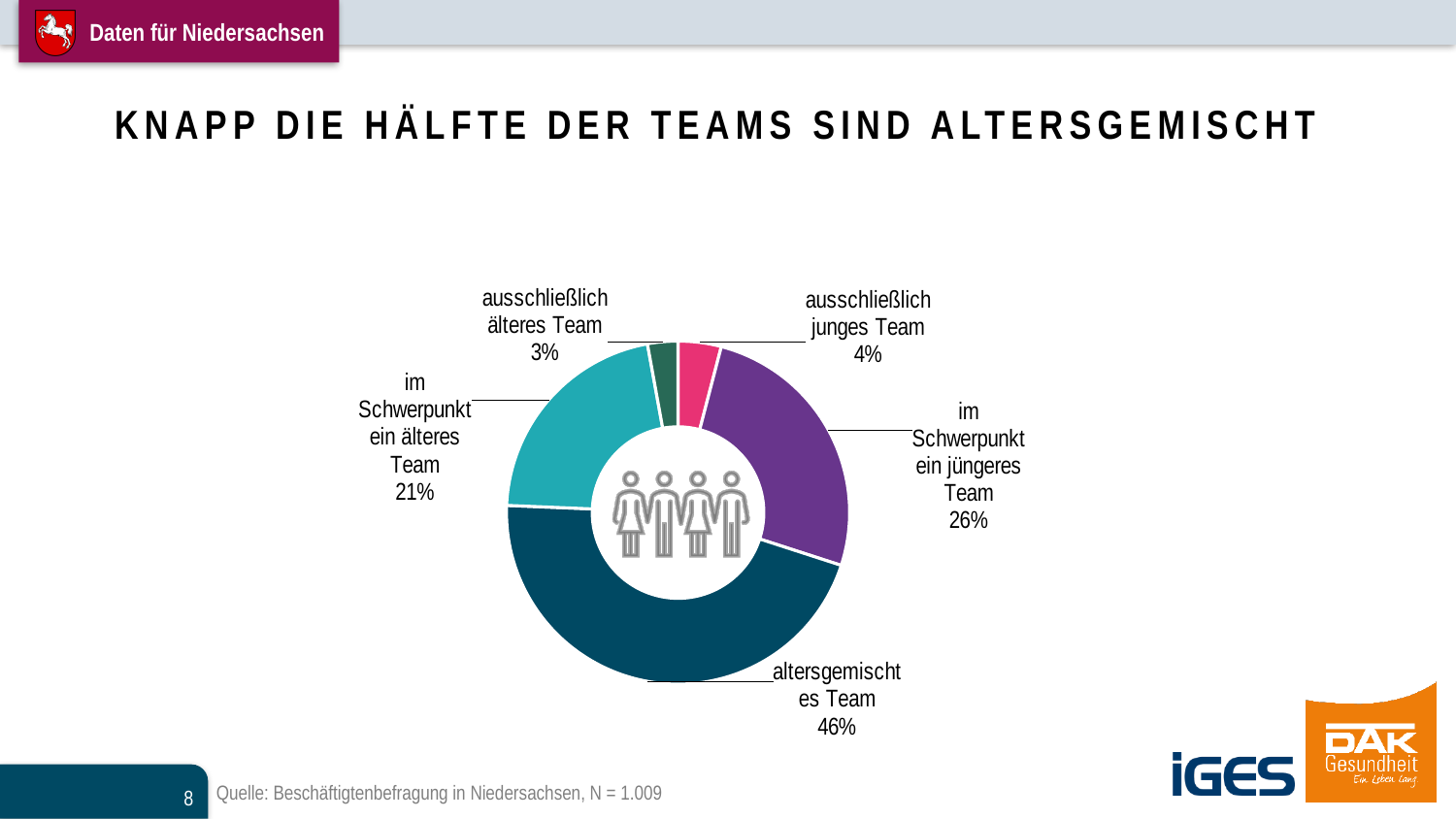
What share of teams is labelled "altersgemischtes Team"? 46% What is the title of the slide? KNAPP DIE HÄLFTE DER TEAMS SIND ALTERSGEMISCHT How many categories are shown in the chart? 5 Which category has the largest share of the chart? altersgemischtes Team Which is larger: the share for "ausschließlich junges Team" or for "ausschließlich älteres Team"? ausschließlich junges Team What is the difference in percentage points between "im Schwerpunkt ein jüngeres Team" and "im Schwerpunkt ein älteres Team"? 5 percentage points What kind of chart is shown on the slide? Pie chart (donut) What percentage is shown for "ausschließlich junges Team"? 4% What percentage is shown for "ausschließlich älteres Team"? 3% What percentage is shown for "im Schwerpunkt ein jüngeres Team"? 26% What percentage is shown for "im Schwerpunkt ein älteres Team"? 21% Which category has the smallest share of the chart? ausschließlich älteres Team